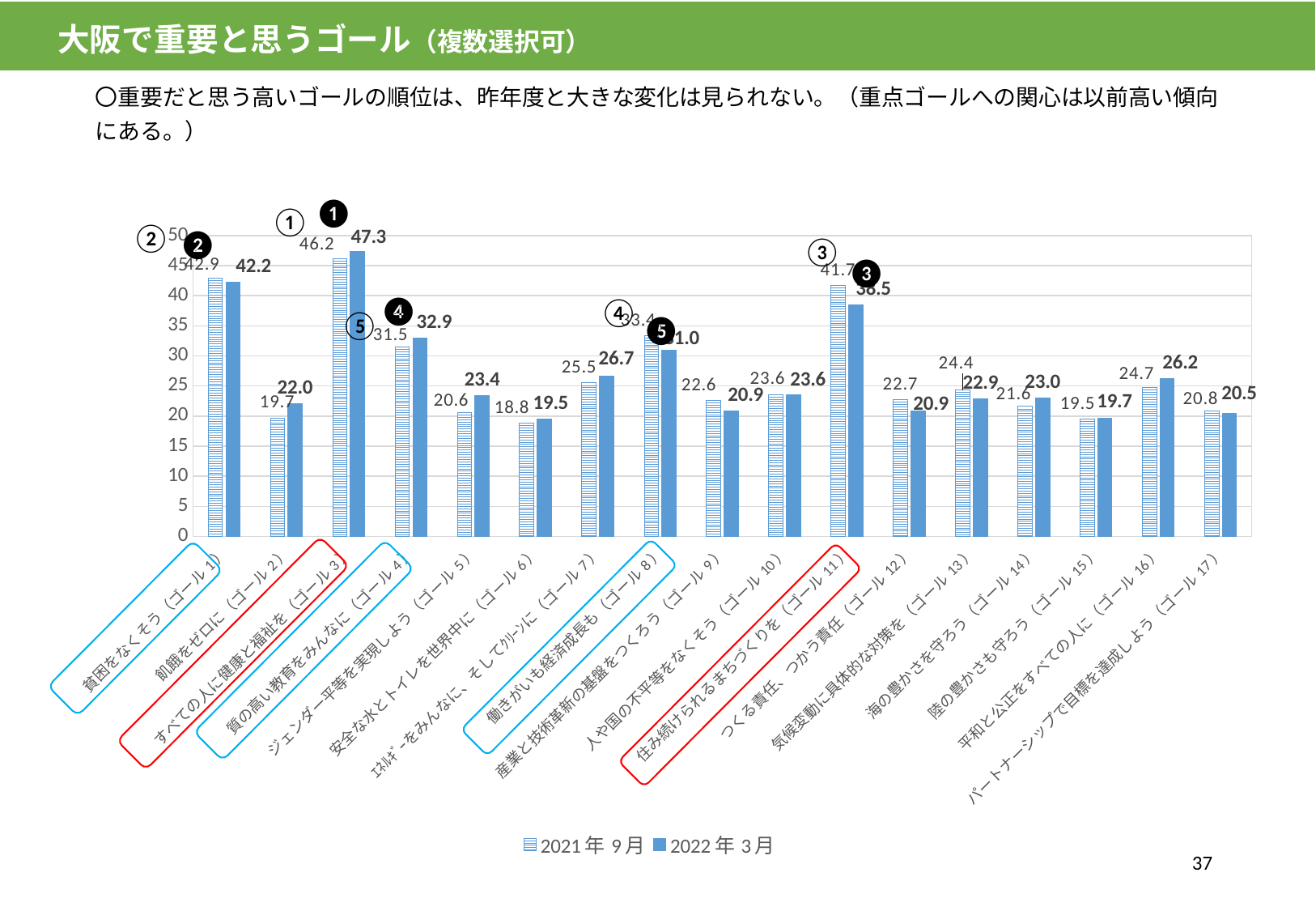
What is the 2022年3月 value for すべての人に健康と福祉を（ゴール3）? 47.3 Which goal has the highest 2022年3月 value? すべての人に健康と福祉を（ゴール3） How many series does the legend list? 2 Is the 2022年3月 value for 働きがいも経済成長も（ゴール8）greater or less than 30? greater What are the two series named in the legend? 2021年 9月 and 2022年 3月 For 気候変動に具体的な対策を（ゴール13）, which series has the larger value, 2021年9月 or 2022年3月? 2021年9月 What is the 2021年9月 value for 住み続けられるまちづくりを（ゴール11）? 41.7 For ジェンダー平等を実現しよう（ゴール5）, what is the difference between the 2022年3月 and 2021年9月 values? 2.8 Which goal has the lowest 2021年9月 value? 安全な水とトイレを世界中に（ゴール6） What is the 2021年9月 value for 平和と公正をすべての人に（ゴール16）? 24.7 How many goals (categories) are plotted on the x axis? 17 What kind of chart is shown on the slide? bar chart